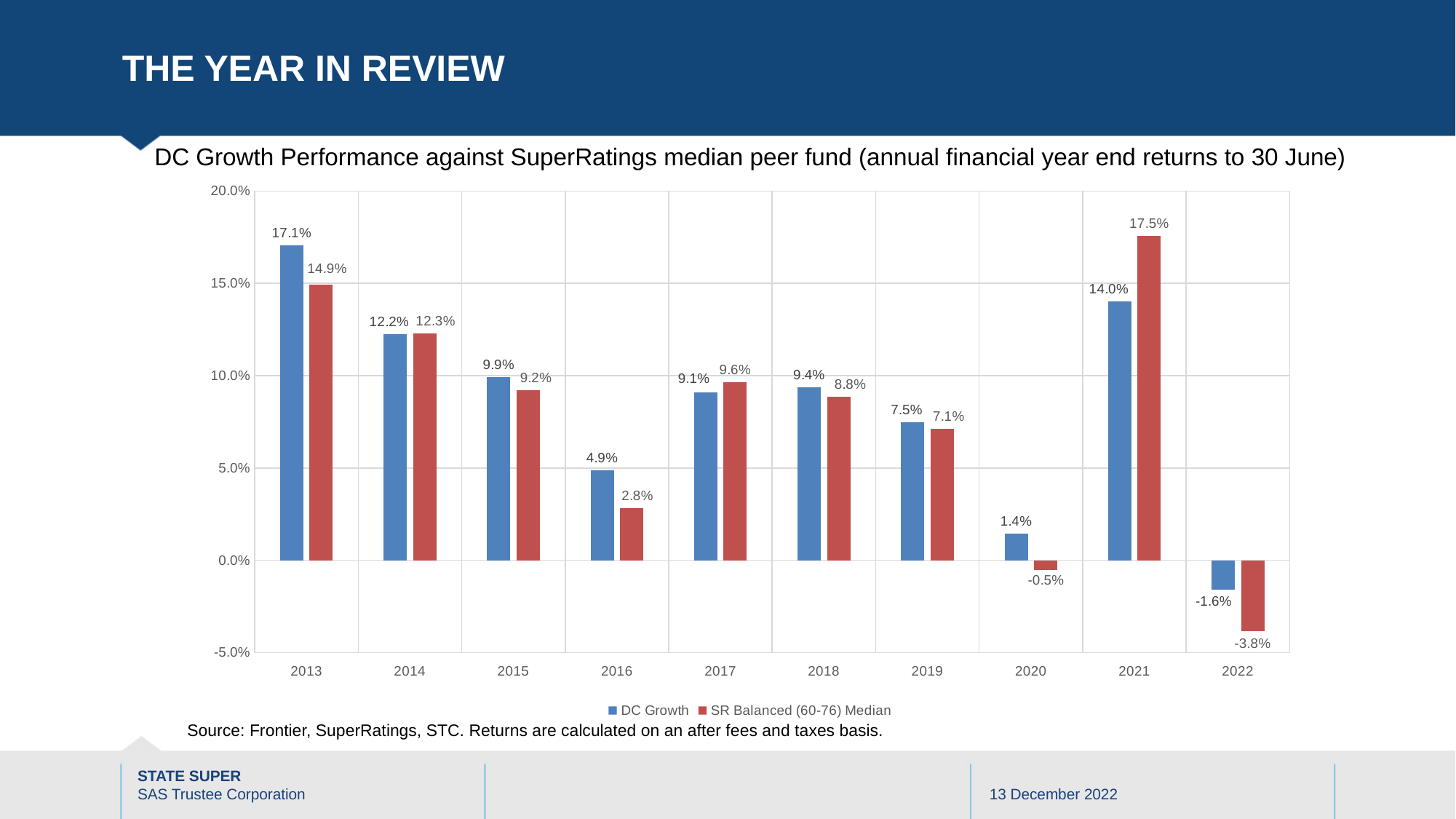
Which was larger in 2020, the DC Growth return or the SR Balanced (60-76) Median return? DC Growth What is the difference between the DC Growth and SR Balanced (60-76) Median returns in 2021? 3.5% What was the SR Balanced (60-76) Median return in 2022? -3.8% In which year was the SR Balanced (60-76) Median return highest? 2021 Which colour represents the SR Balanced (60-76) Median series? Red How many years are shown on the x axis? 10 What type of chart is shown on the slide? Bar chart In which year was the DC Growth return lowest? 2022 What was the DC Growth return in 2013? 17.1% What is the difference between the DC Growth return in 2013 and in 2014? 4.9% How many series does the legend list? 2 What was the SR Balanced (60-76) Median return in 2016? 2.8%